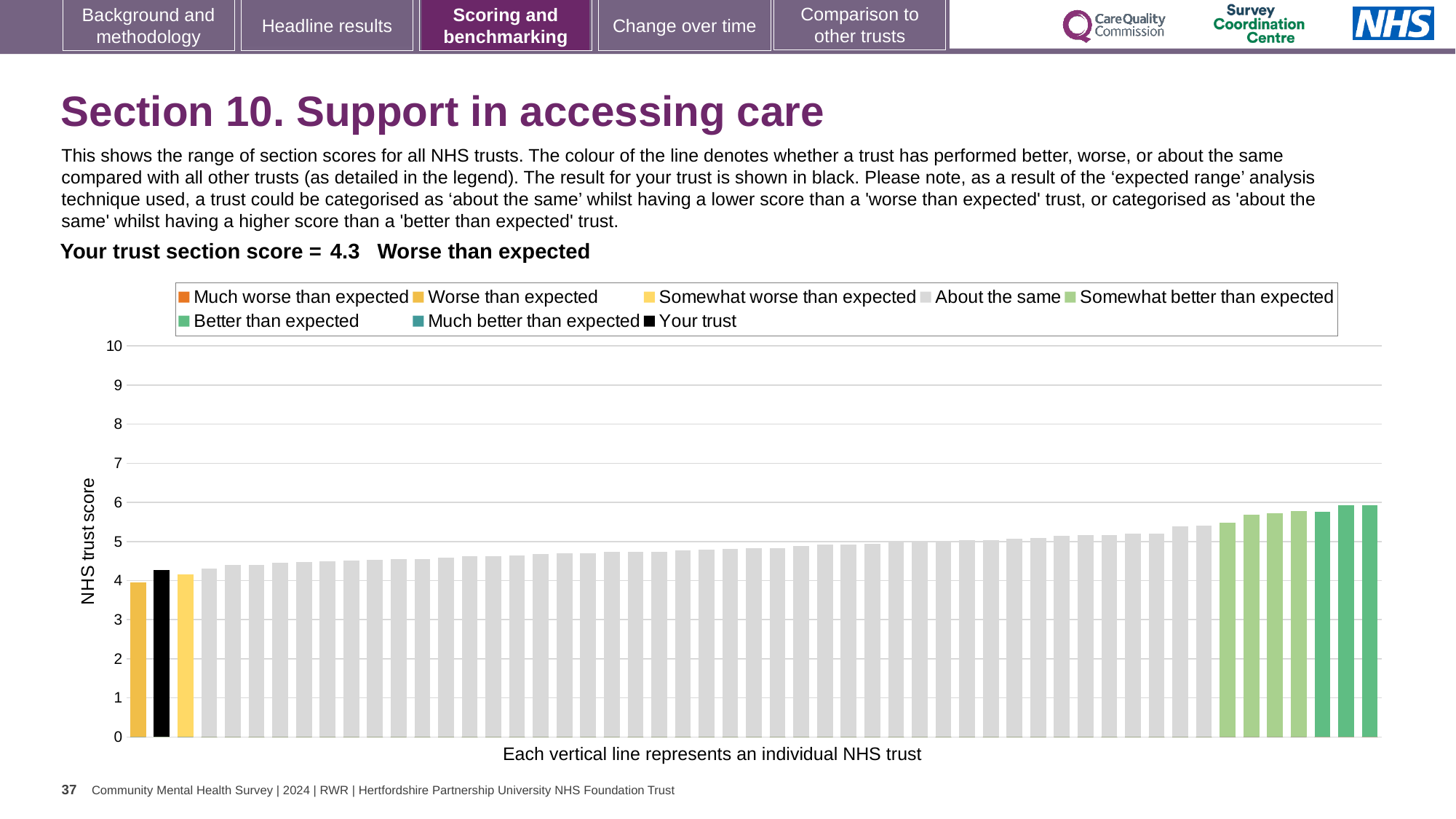
Is the value for your trust greater or less than 5? less How many entries does the chart legend list? 8 What kind of chart is shown on the slide? bar chart What colour is the bar representing your trust? black Is the value of the leftmost bar greater or less than 5? less Do the bar values rise or fall from left to right across the chart? rise What is the label on the vertical axis of the chart? NHS trust score Which performance category is your trust's section score assigned to? Worse than expected Is the leftmost bar higher or lower than the black bar for your trust? lower Is the value of the tallest bar greater or less than 7? less What is the section score for your trust shown on the slide? 4.3